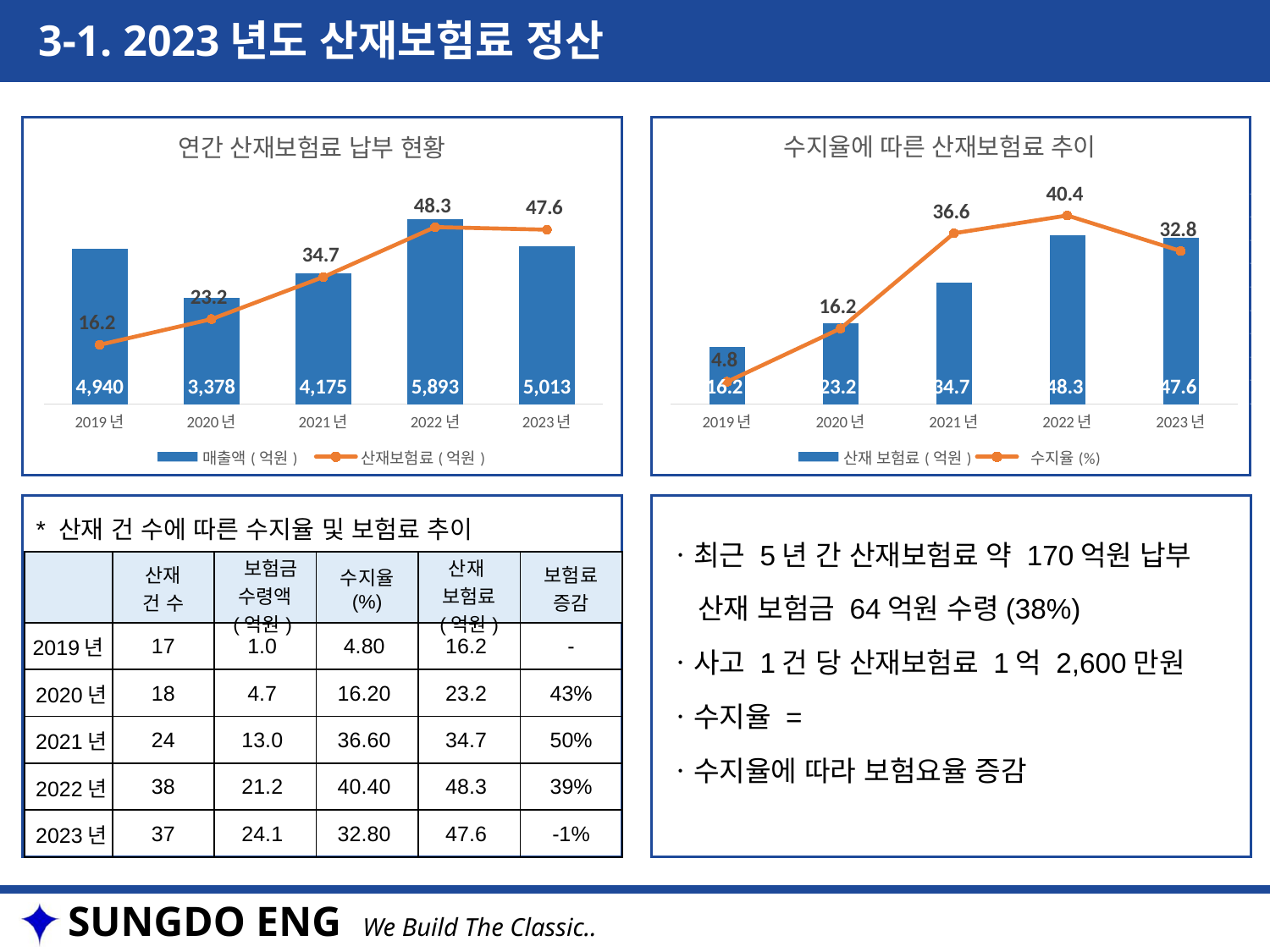
In the chart titled '수지율에 따른 산재보험료 추이', which year has the lowest 수지율? 2019년 In the chart titled '수지율에 따른 산재보험료 추이', which year has the highest 수지율? 2022년 In the chart titled '연간 산재보험료 납부 현황', what is the 산재보험료 value for 2021년? 34.7 In the chart titled '연간 산재보험료 납부 현황', which year has the highest 산재보험료? 2022년 In the chart titled '연간 산재보험료 납부 현황', how many series does the legend list? 2 In the chart titled '연간 산재보험료 납부 현황', which year has the lowest 매출액? 2020년 In the chart titled '수지율에 따른 산재보험료 추이', is the 수지율 for 2022년 or 2023년 larger? 2022년 In the chart titled '연간 산재보험료 납부 현황', what is the 매출액 value for 2022년? 5,893 In the chart titled '수지율에 따른 산재보험료 추이', how many years are shown on the x axis? 5 In the chart titled '연간 산재보험료 납부 현황', what is the difference in 매출액 between 2022년 and 2020년? 2,515 What kind of chart is the chart titled '수지율에 따른 산재보험료 추이'? Combined bar and line chart In the chart titled '수지율에 따른 산재보험료 추이', what is the 수지율 value for 2021년? 36.6